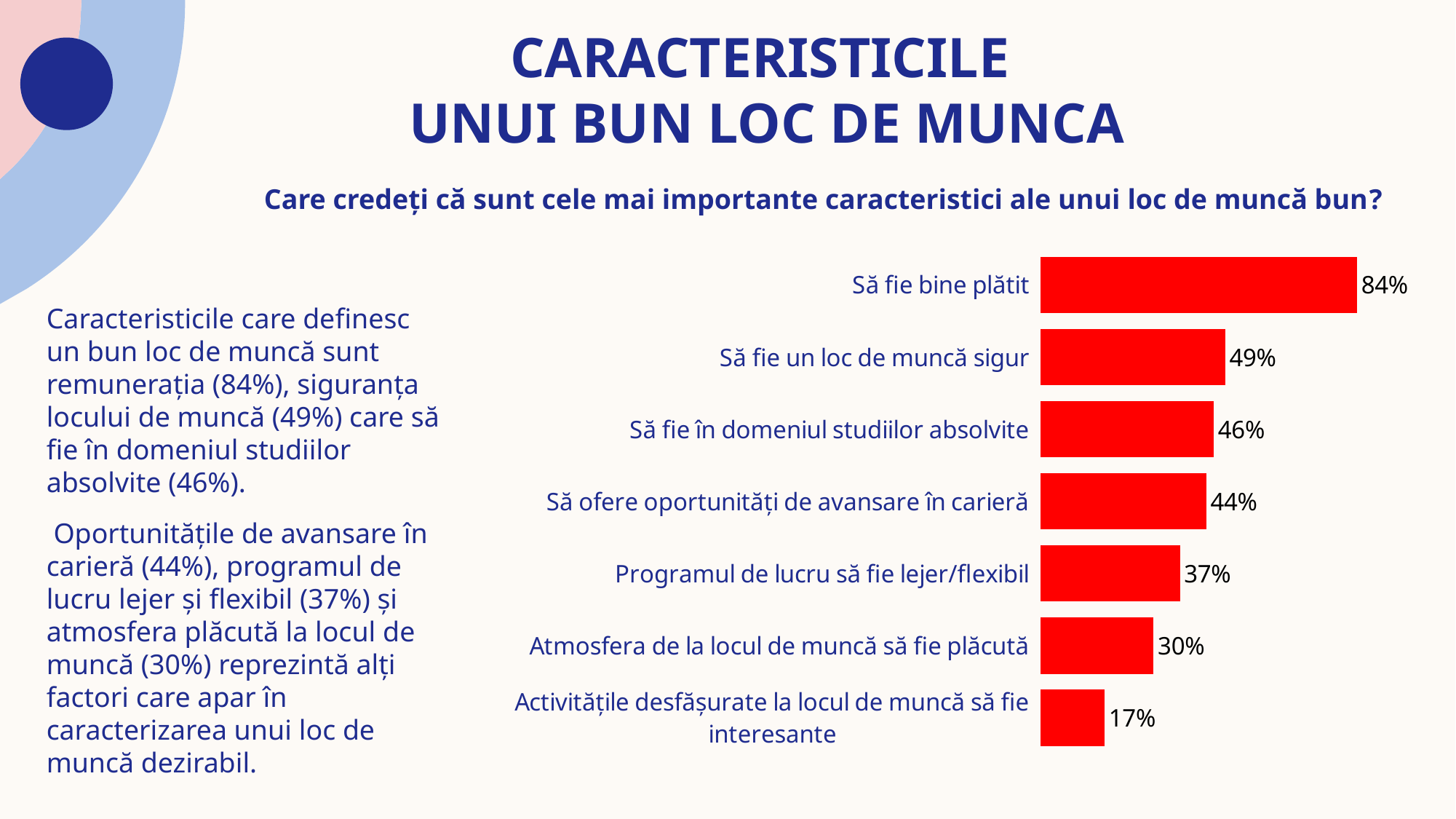
What colour are the bars in the chart? Red What is the value for "Programul de lucru să fie lejer/flexibil"? 37% What kind of chart is shown on the slide? Bar chart What is the value for "Să fie bine plătit"? 84% Which category has the highest value? Să fie bine plătit Which is larger: the value for "Să fie în domeniul studiilor absolvite" or for "Să ofere oportunități de avansare în carieră"? Să fie în domeniul studiilor absolvite Which category has the lowest value? Activitățile desfășurate la locul de muncă să fie interesante What is the difference between the values for "Atmosfera de la locul de muncă să fie plăcută" and "Activitățile desfășurate la locul de muncă să fie interesante"? 13% Do the values rise or fall going from the top bar to the bottom bar? Fall How many categories are shown in the chart? 7 What is the difference between the values for "Să fie bine plătit" and "Să fie un loc de muncă sigur"? 35% What is the value for "Activitățile desfășurate la locul de muncă să fie interesante"? 17%